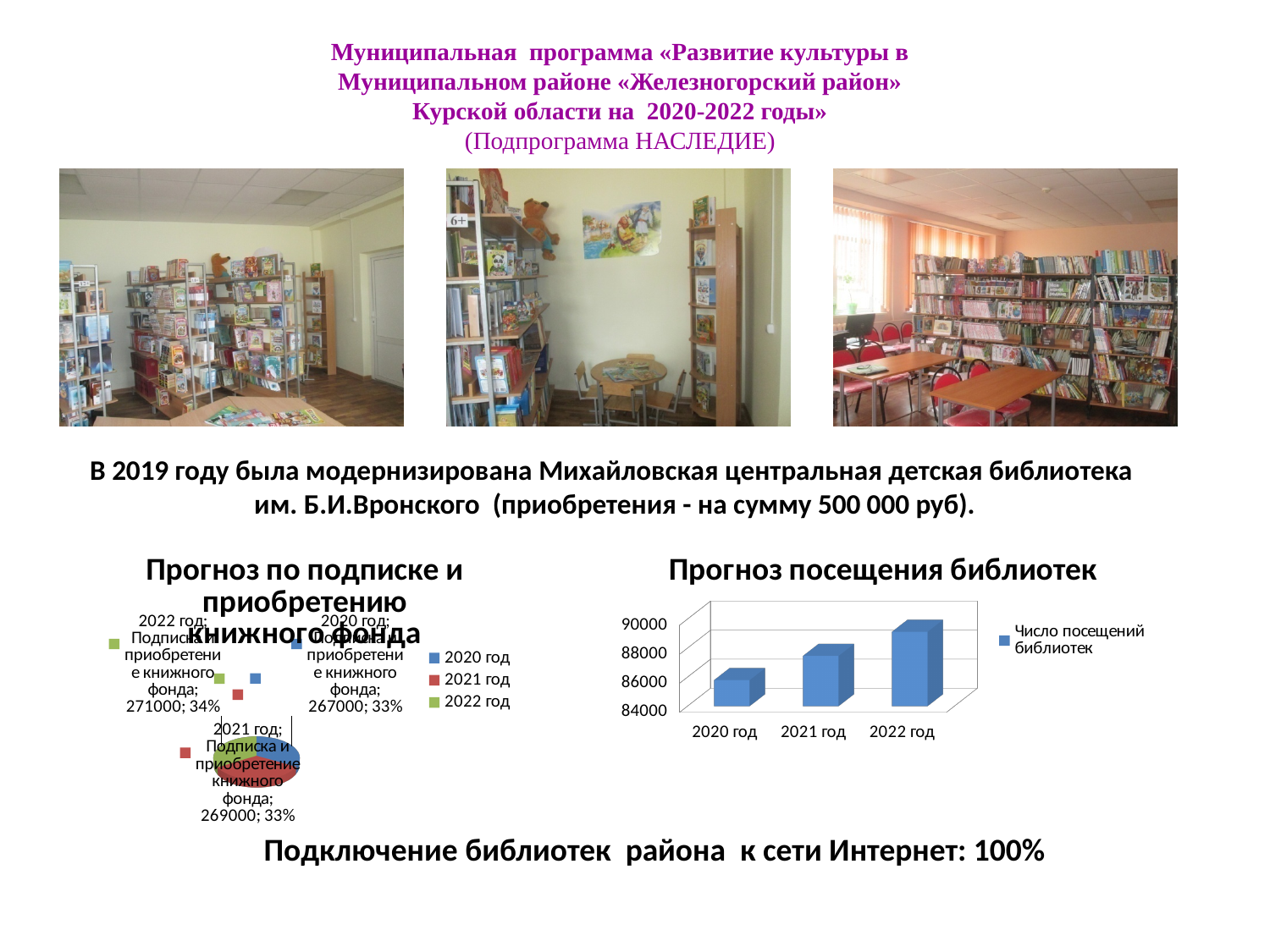
What kind of chart is 'Прогноз посещения библиотек'? bar chart In the chart 'Прогноз по подписке и приобретению книжного фонда', what is the value for 2020 год? 267000 In the chart 'Прогноз по подписке и приобретению книжного фонда', what share of the pie does 2022 год have? 34% In the chart 'Прогноз по подписке и приобретению книжного фонда', what is the difference between the values for 2022 год and 2020 год? 4000 In the chart 'Прогноз по подписке и приобретению книжного фонда', how many slices does the pie have? 3 In the chart 'Прогноз посещения библиотек', what series does the legend list? Число посещений библиотек In the chart 'Прогноз посещения библиотек', is the value for 2022 год greater or less than 88000? greater In the chart 'Прогноз по подписке и приобретению книжного фонда', what share of the pie does 2021 год have? 33% In the chart 'Прогноз посещения библиотек', which year has the highest number of visits? 2022 год In the chart 'Прогноз посещения библиотек', do the values rise or fall from 2020 год to 2022 год? rise What kind of chart is 'Прогноз по подписке и приобретению книжного фонда'? pie chart In the chart 'Прогноз по подписке и приобретению книжного фонда', what is the value for 2022 год? 271000